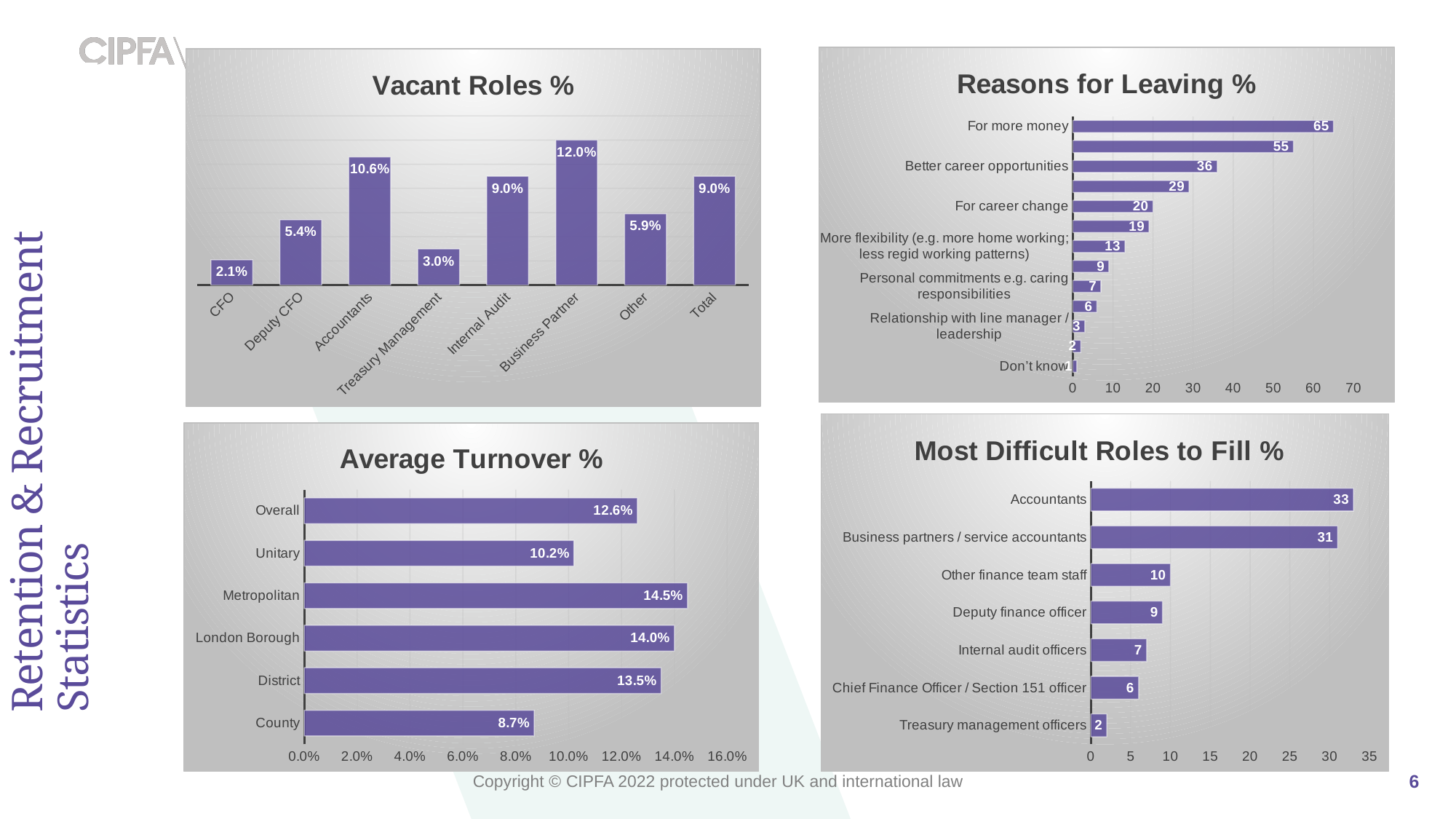
What type of chart is the Most Difficult Roles to Fill % chart? Bar chart In the Vacant Roles % chart, which category has the lowest value? CFO In the Vacant Roles % chart, what is the value for Business Partner? 12.0% In the Vacant Roles % chart, what is the difference between Accountants and Deputy CFO? 5.2% In the Most Difficult Roles to Fill % chart, what is the difference between Accountants and Business partners / service accountants? 2 In the Reasons for Leaving % chart, what is the value for For career change? 20 How many categories are shown in the Vacant Roles % chart? 8 In the Reasons for Leaving % chart, what is the value for For more money? 65 In the Average Turnover % chart, which category has the highest value? Metropolitan In the Reasons for Leaving % chart, is the value for Better career opportunities greater or less than 30? greater In the Average Turnover % chart, which is larger, London Borough or District? London Borough In the Average Turnover % chart, what is the value for County? 8.7%